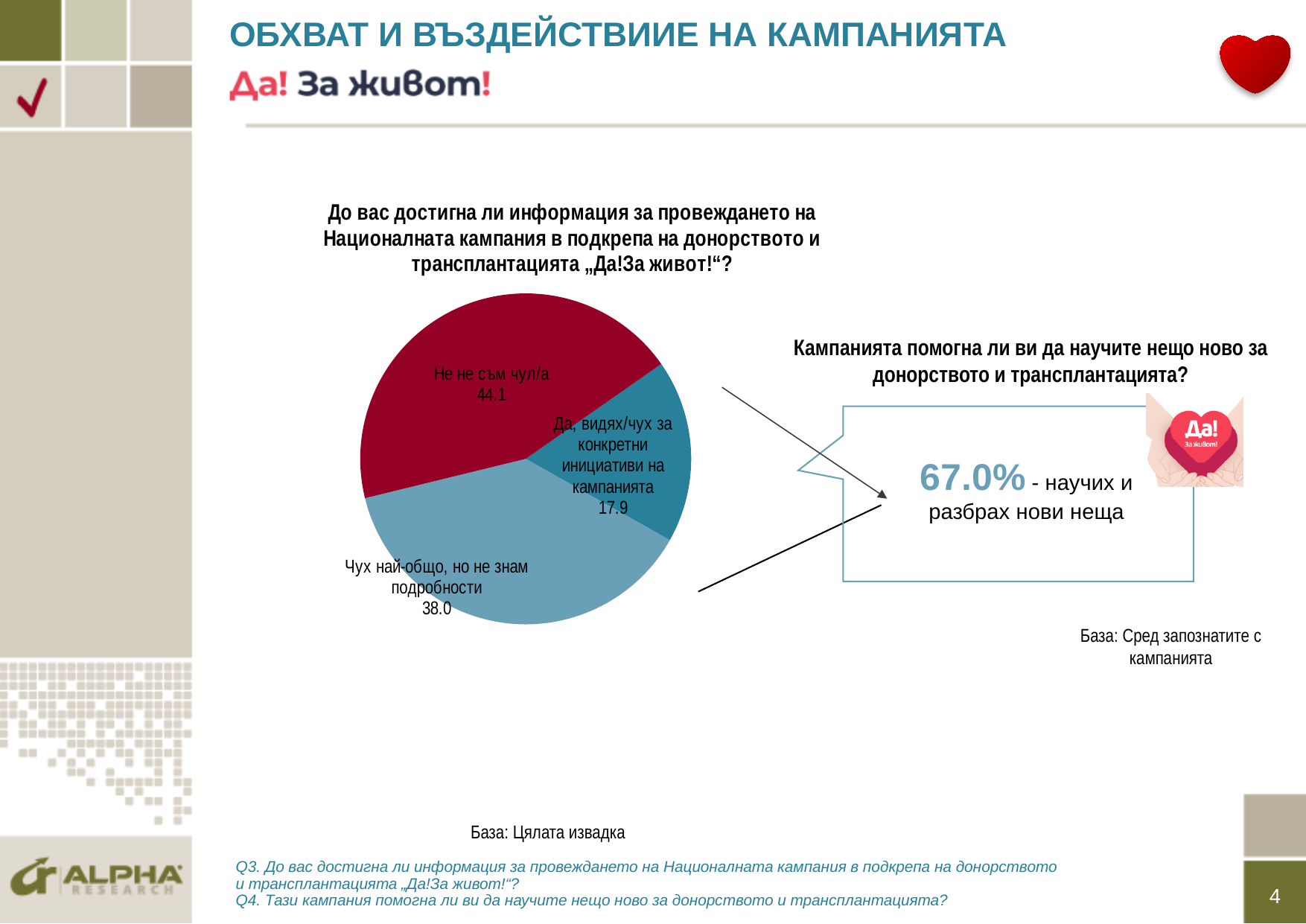
What is the difference between the values for "Чух най-общо, но не знам подробности" and "Да, видях/чух за конкретни инициативи на кампанията"? 20.1 Which slice of the pie chart is the largest? Не не съм чул/а What is the difference between the values for "Не не съм чул/а" and "Чух най-общо, но не знам подробности"? 6.1 What colour is the "Не не съм чул/а" slice of the pie chart? dark red What base is stated below the pie chart? База: Цялата извадка How many slices does the pie chart have? 3 What is the value for "Не не съм чул/а" in the pie chart? 44.1 What is the value for "Да, видях/чух за конкретни инициативи на кампанията" in the pie chart? 17.9 What kind of chart is shown on the slide? pie chart Which slice of the pie chart is the smallest? Да, видях/чух за конкретни инициативи на кампанията Which is larger in the pie chart: "Чух най-общо, но не знам подробности" or "Да, видях/чух за конкретни инициативи на кампанията"? Чух най-общо, но не знам подробности What is the value for "Чух най-общо, но не знам подробности" in the pie chart? 38.0